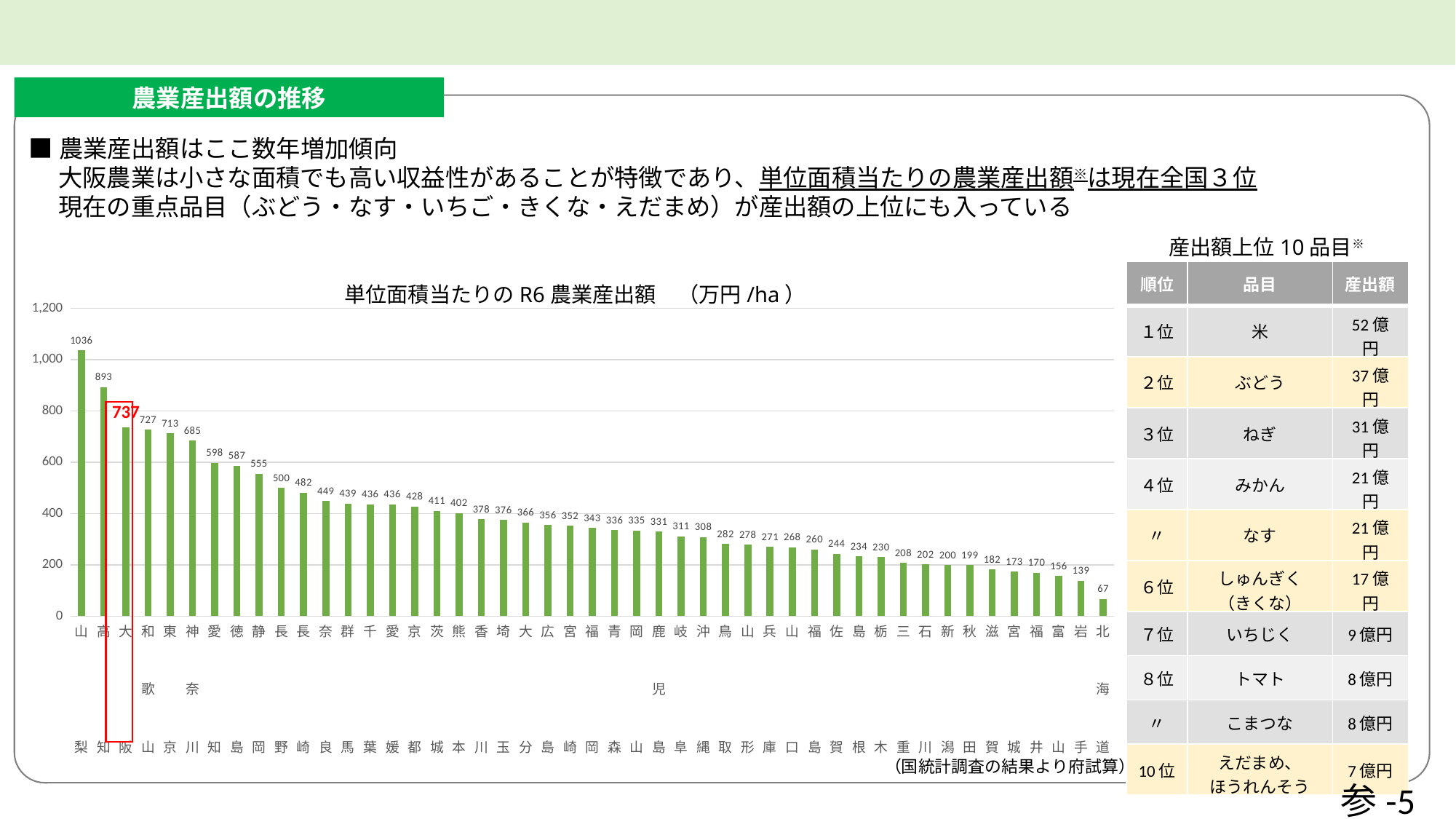
What is the value for 山梨 in the chart? 1036 What is the title of the chart? 単位面積当たりのR6農業産出額（万円/ha） What type of chart is shown on the slide? bar chart What is the value for 北海道 in the chart? 67 How many prefectures (bars) are plotted in the chart? 47 What is the value for 大阪 in the chart? 737 Is the value for 東京 greater or less than 600? greater What is the difference between the values for 山梨 and 高知? 143 Which prefecture has the highest value in the chart? 山梨 Which has a larger value, 大阪 or 和歌山? 大阪 Do the values rise or fall from left to right along the x axis? fall Which prefecture has the lowest value in the chart? 北海道